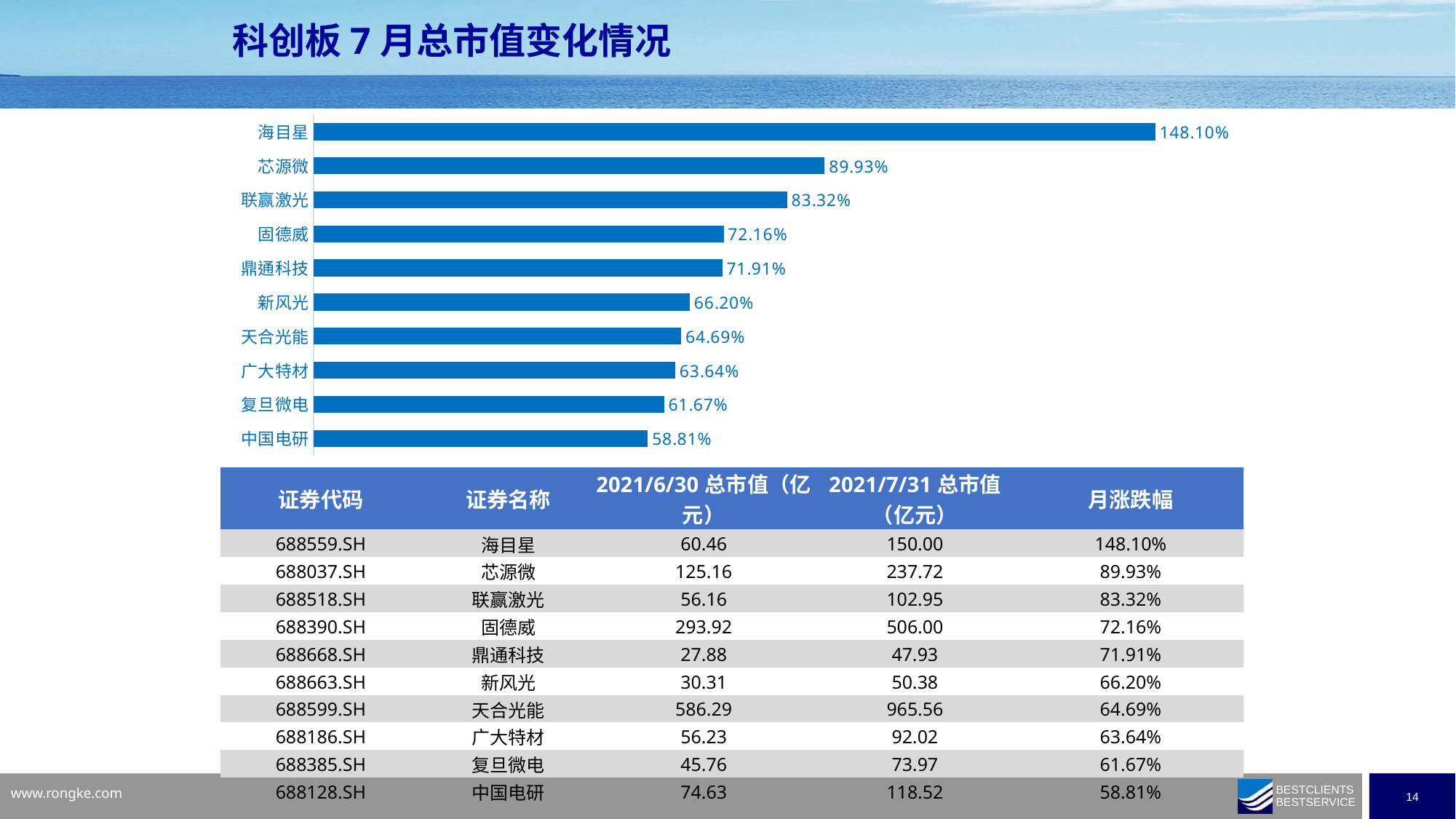
Which category has the highest value in the bar chart? 海目星 What is the value shown for 固德威 in the bar chart? 72.16% Which has a larger value in the bar chart, 广大特材 or 中国电研? 广大特材 Which has a larger value in the bar chart, 联赢激光 or 鼎通科技? 联赢激光 What is the title of the slide containing the chart? 科创板 7 月总市值变化情况 What is the value shown for 海目星 in the bar chart? 148.10% What is the difference between the values for 海目星 and 芯源微 in the bar chart? 58.17% Which category has the lowest value in the bar chart? 中国电研 What kind of chart is shown on the slide? Bar chart What is the difference between the values for 新风光 and 天合光能 in the bar chart? 1.51% How many categories are shown in the bar chart? 10 What is the value shown for 复旦微电 in the bar chart? 61.67%